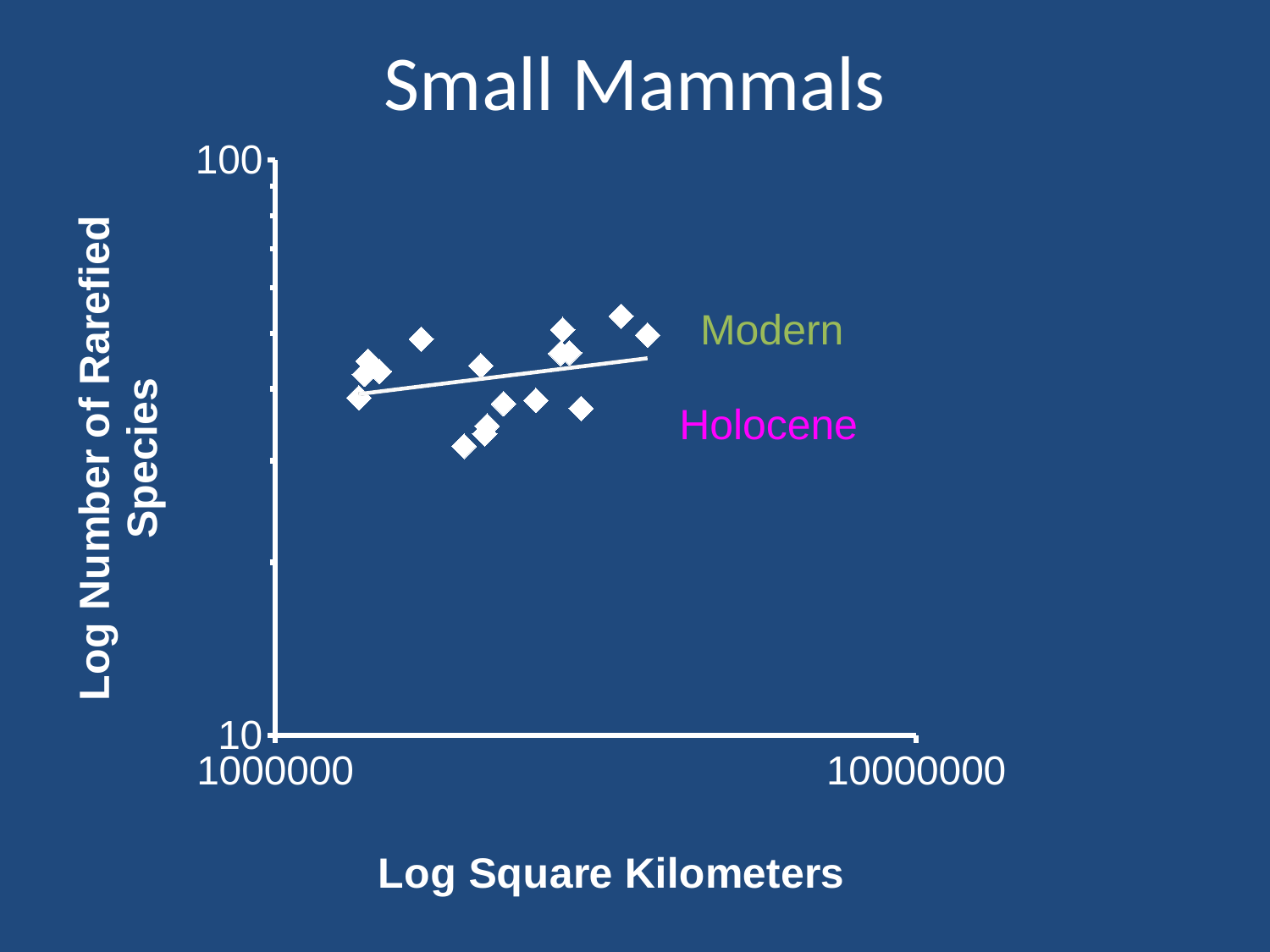
Are all the plotted points greater or less than 10000000 on the x axis? less Are all the plotted points greater or less than 10 on the y axis? greater What is the lowest value shown on the y axis? 10 What kind of chart is shown on the slide? scatter chart What is the label of the x axis? Log Square Kilometers Do the plotted values generally rise or fall as the x axis increases, according to the fitted line? rise Are all the plotted points greater or less than 100 on the y axis? less What is the title of the chart? Small Mammals How many groups are labelled on the chart? 2